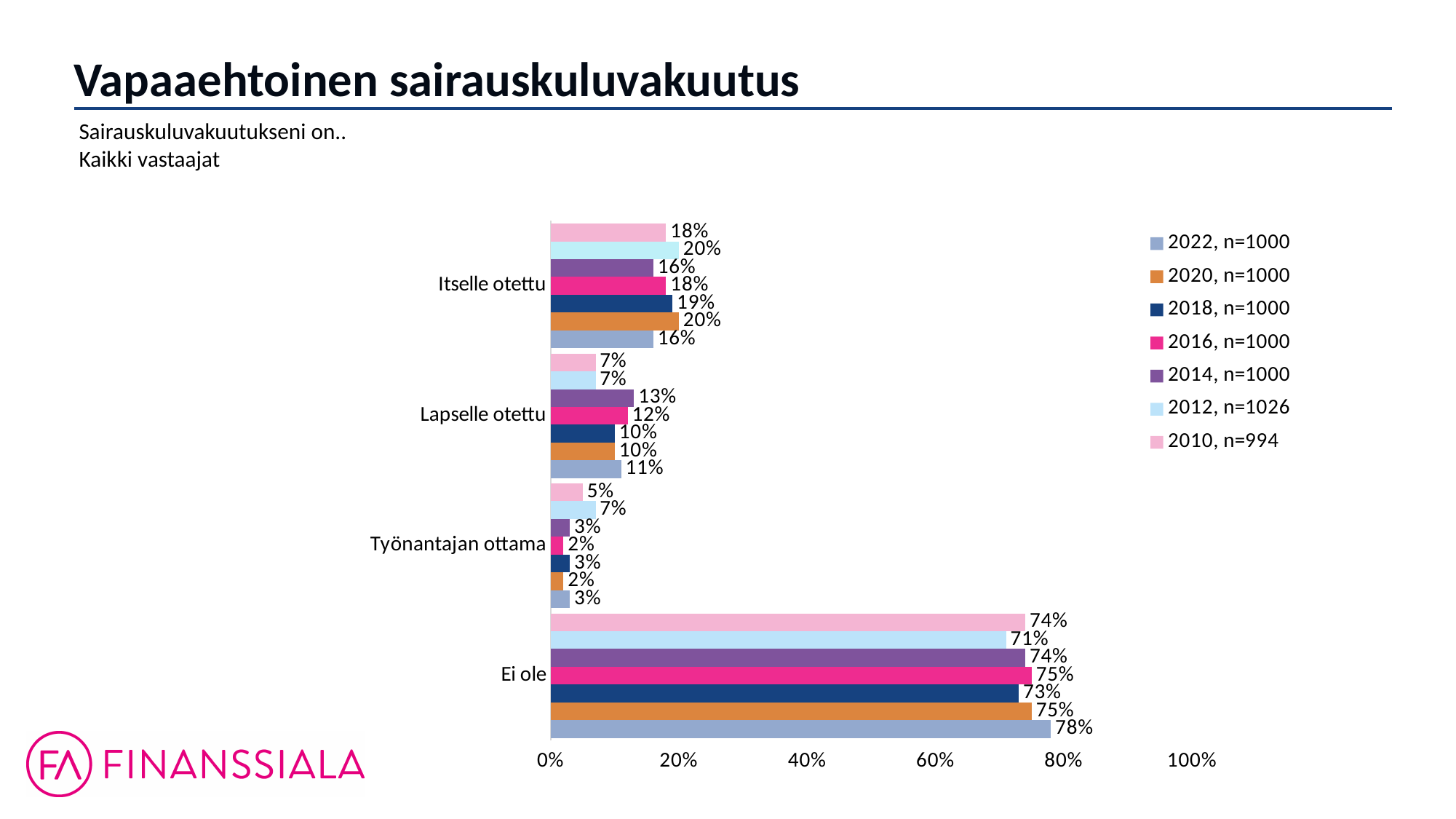
What is the value for "Ei ole" in the 2022 series? 78% How many series does the legend list? 7 What is the value for "Itselle otettu" in the 2018 series? 19% How many categories are shown on the y axis? 4 What is the value for "Lapselle otettu" in the 2014 series? 13% What kind of chart is shown on the slide? Bar chart What is the value for "Työnantajan ottama" in the 2012 series? 7% Which category has the lowest value in the 2016 series? Työnantajan ottama What is the difference between the 2022 and 2012 values for "Ei ole"? 7% What is the sample size (n) shown in the legend for the 2010 series? 994 Which category has the highest value in the 2022 series? Ei ole Which is larger for "Lapselle otettu": the 2014 value or the 2010 value? 2014